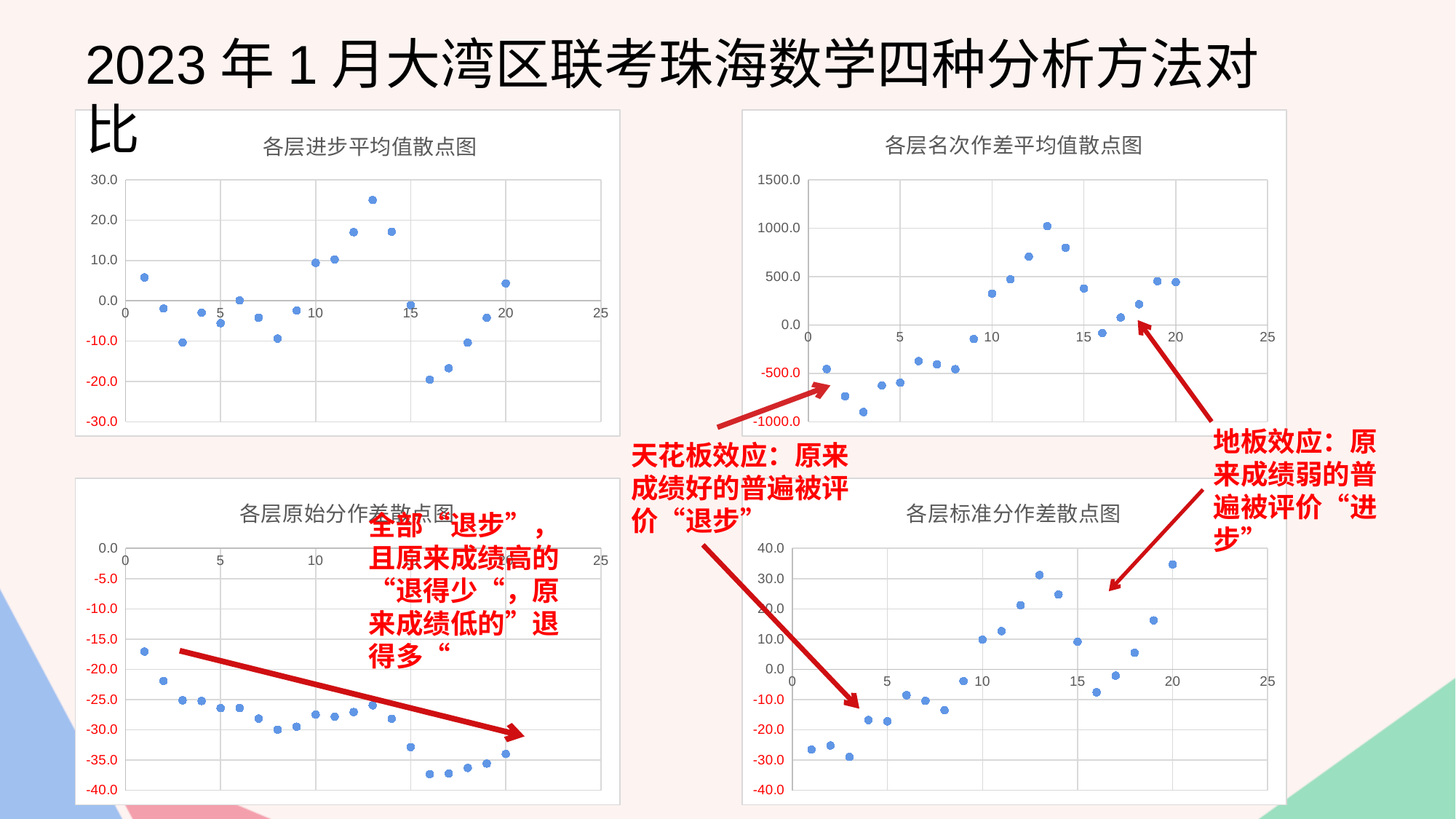
What kind of chart is the top-left chart titled 各层进步平均值散点图? scatter chart In the bottom-left chart 各层原始分作差散点图, is the value at x = 1 greater or less than -20.0? greater In the top-right chart 各层名次作差平均值散点图, is the value at x = 3 greater or less than -500.0? less In the top-left chart 各层进步平均值散点图, is the value at x = 16 greater or less than -10.0? less In the top-right chart 各层名次作差平均值散点图, at which x value is the lowest point? 3 How many charts are shown on the slide? 4 In the top-left chart 各层进步平均值散点图, at which x value is the highest point? 13 In the bottom-right chart 各层标准分作差散点图, at which x value is the lowest point? 3 In the top-left chart 各层进步平均值散点图, how many data points are plotted? 20 In the bottom-left chart 各层原始分作差散点图, do the values generally rise or fall as x increases? fall